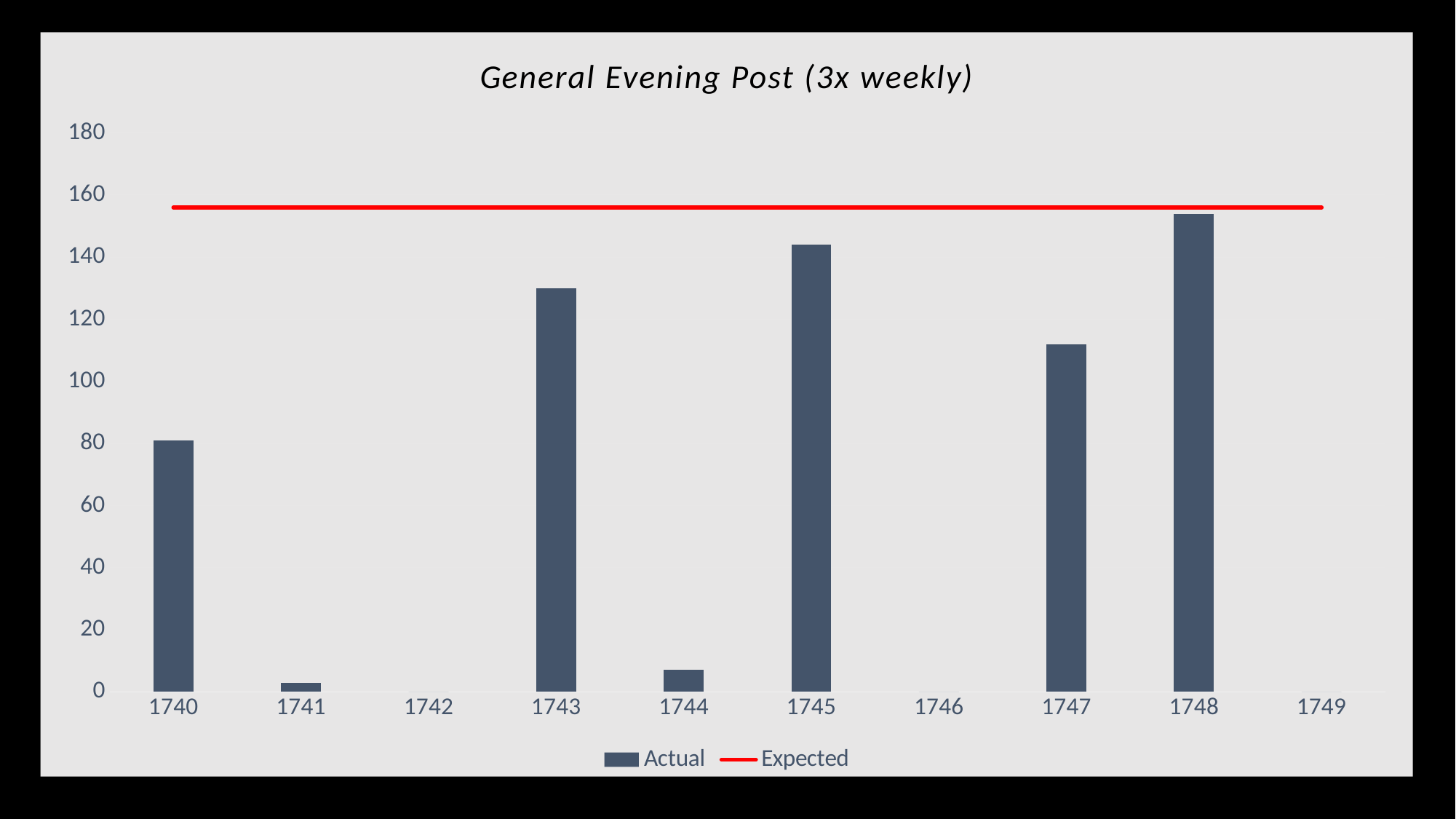
What colour is the Expected line in the chart? red Is the Actual value for 1747 greater or less than 100? greater Is the Actual value for 1743 greater or less than 120? greater How many series does the legend list? 2 Is the Actual value for 1748 greater or less than 160? less Which has the larger Actual value, 1743 or 1747? 1743 What kind of chart is used to show the Actual values? bar chart What is the title of the chart? General Evening Post (3x weekly) How many years are shown along the x axis? 10 Which has the larger Actual value, 1745 or 1748? 1748 Which year has the highest Actual value? 1748